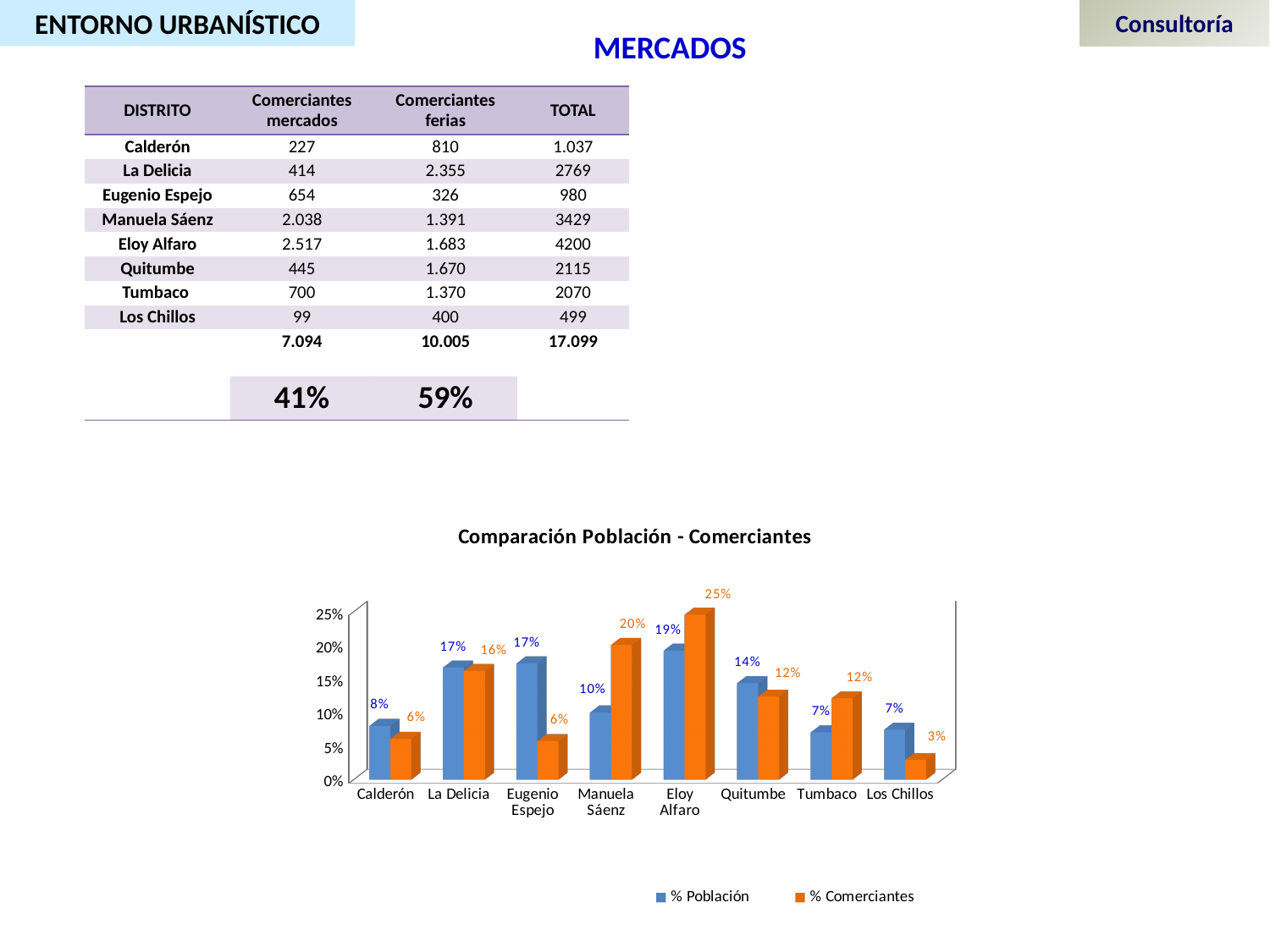
How many districts are shown on the x axis of the chart? 8 What is the difference between % Comerciantes and % Población for Manuela Sáenz? 10% Which series is shown in orange in the chart? % Comerciantes How many series does the chart legend list? 2 For Eugenio Espejo, which is larger: % Población or % Comerciantes? % Población What type of chart is shown on the slide? bar chart Which district has the highest % Comerciantes value? Eloy Alfaro What is the % Comerciantes value for Los Chillos? 3% What is the % Comerciantes value for Eloy Alfaro? 25% Which district has the lowest % Comerciantes value? Los Chillos What is the title of the chart? Comparación Población - Comerciantes What is the % Población value for Manuela Sáenz? 10%